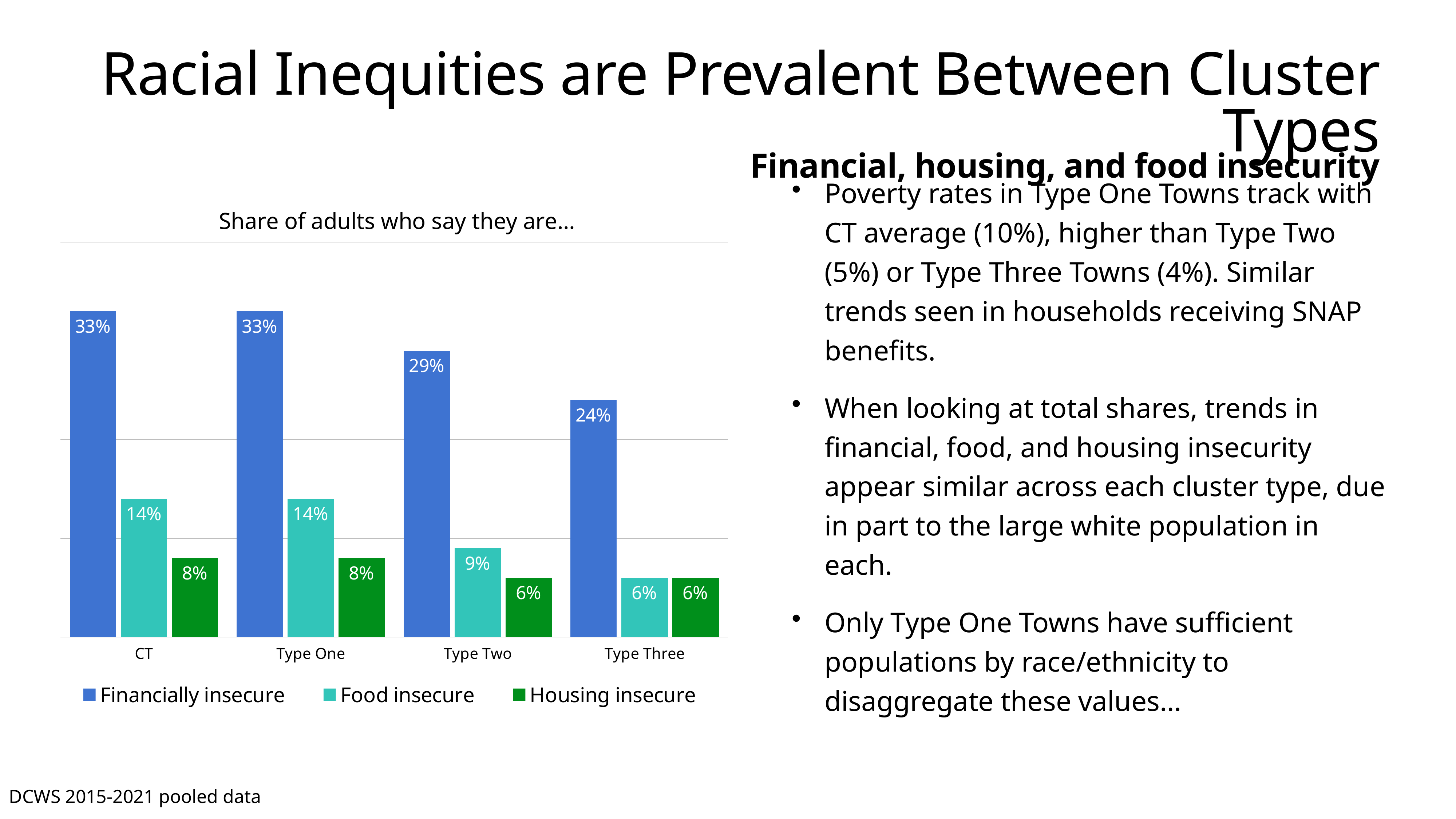
What share of adults in Type Two are financially insecure? 29% How many categories are shown on the x axis of the chart? 4 What is the difference between the financially insecure share in CT and in Type Three? 9% What is the title of the chart? Share of adults who say they are… What is the difference between the food insecure and housing insecure shares in Type One? 6% What share of adults in Type Three are food insecure? 6% What share of adults in CT are housing insecure? 8% How many series does the chart legend list? 3 Which category has the highest share of food insecure adults, CT or Type Two? CT What kind of chart is shown on the slide? bar chart Which category has the lowest share of financially insecure adults? Type Three Is the financially insecure share for Type Two larger or smaller than the financially insecure share for Type Three? larger